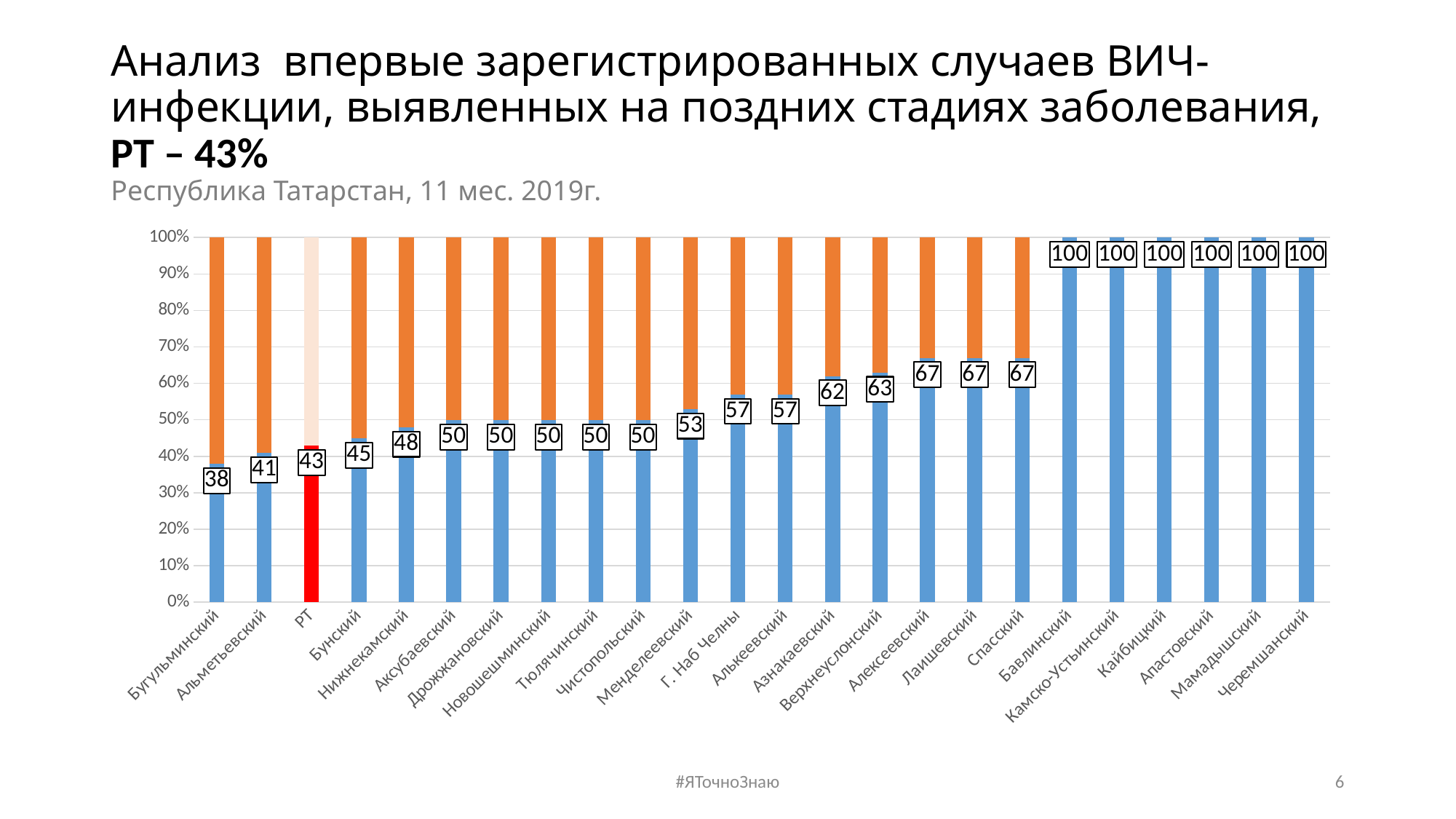
Do the labelled values rise or fall from left to right along the x axis? Rise What is the difference between the labelled values for Спасский and Бугульминский? 29 What kind of chart is shown on the slide? Stacked bar chart Which has the larger labelled value, Верхнеуслонский or Нижнекамский? Верхнеуслонский Which category has the lowest labelled value? Бугульминский How many categories are shown on the x axis? 24 What is the labelled value for the red РТ bar? 43 How many categories have a labelled value of 100? 6 What is the labelled value for Азнакаевский? 62 What is the labelled value for Г. Наб Челны? 57 What is the labelled value for Бугульминский? 38 What is the highest labelled value shown on the chart? 100